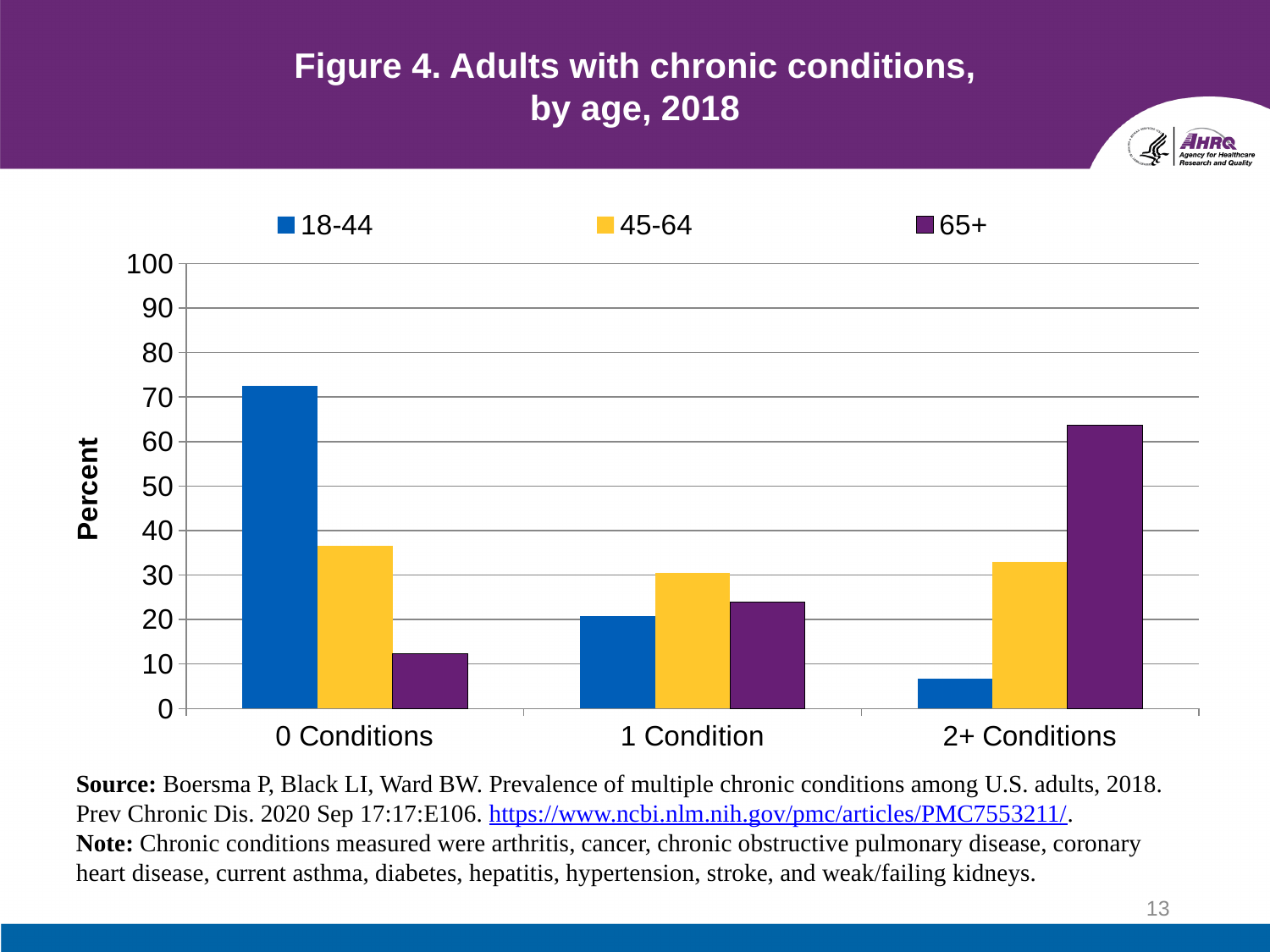
Is the value for 65+ at 2+ Conditions greater or less than 60? greater What kind of chart is shown on the slide? Bar chart Which age group has the lowest bar for 0 Conditions? 65+ Which age group has the highest bar for 0 Conditions? 18-44 How many condition categories are shown on the x axis? 3 How many age groups does the legend list? 3 Do the values for the 65+ age group rise or fall from 0 Conditions to 2+ Conditions? rise Is the value for 18-44 at 0 Conditions greater or less than 60? greater Which age group has the lowest bar for 2+ Conditions? 18-44 Is the value for 18-44 at 2+ Conditions greater or less than 10? less Which is larger: the 18-44 bar for 0 Conditions or the 65+ bar for 2+ Conditions? 18-44 bar for 0 Conditions Which age group has the highest bar for 2+ Conditions? 65+